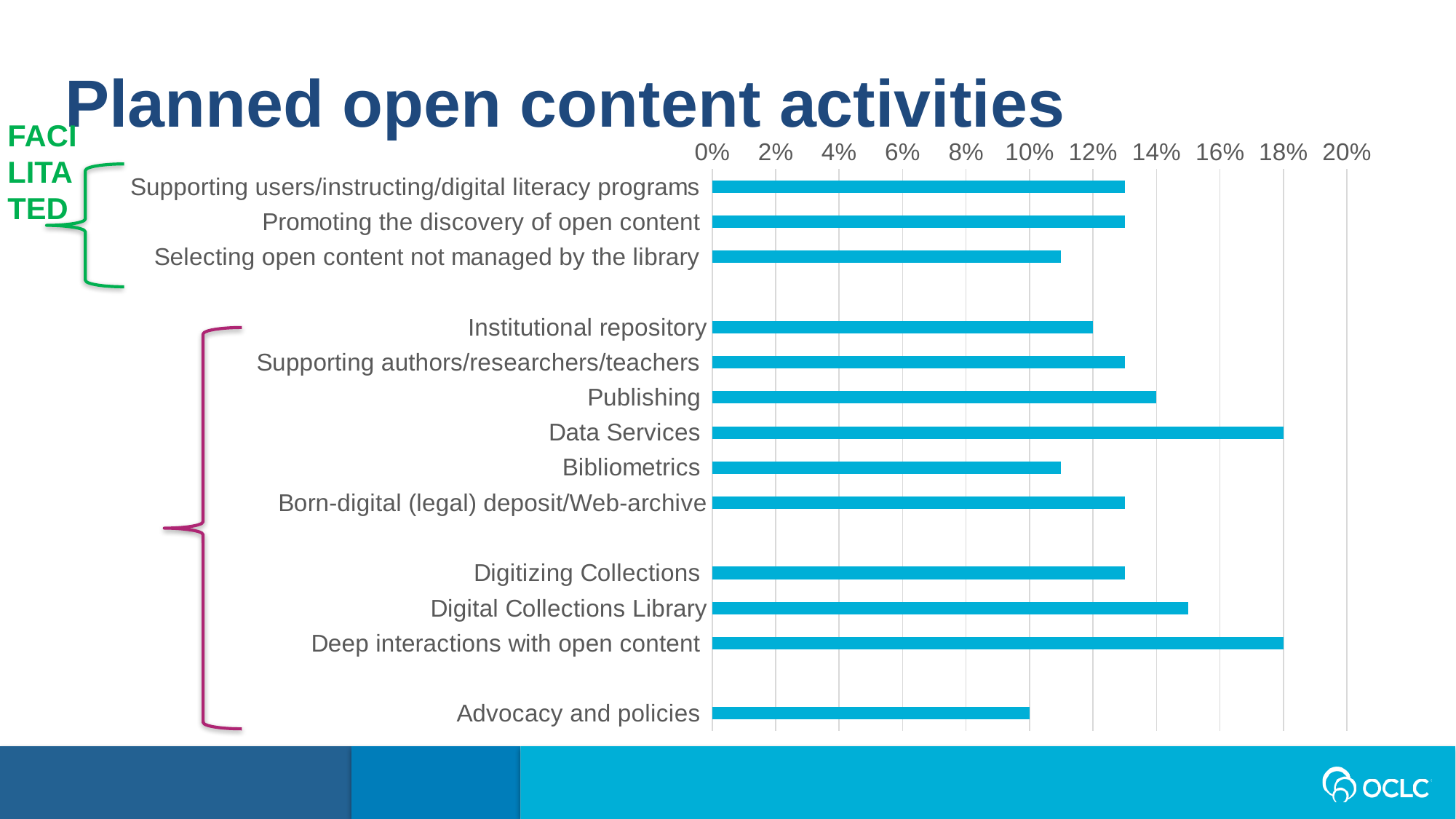
What is the value for Data Services? 18% How many activity categories are plotted in the chart? 13 Which has a larger value, Data Services or Digitizing Collections? Data Services Is the value for Digital Collections Library greater or less than 14%? greater What is the difference between the values for Data Services and Advocacy and policies? 8% What type of chart is shown on the slide? bar chart What is the value for Publishing? 14% What is the title of the chart on the slide? Planned open content activities Which activity has the lowest value in the chart? Advocacy and policies What is the value for Advocacy and policies? 10% Is the value for Bibliometrics greater or less than 12%? less Which has a larger value, Publishing or Bibliometrics? Publishing